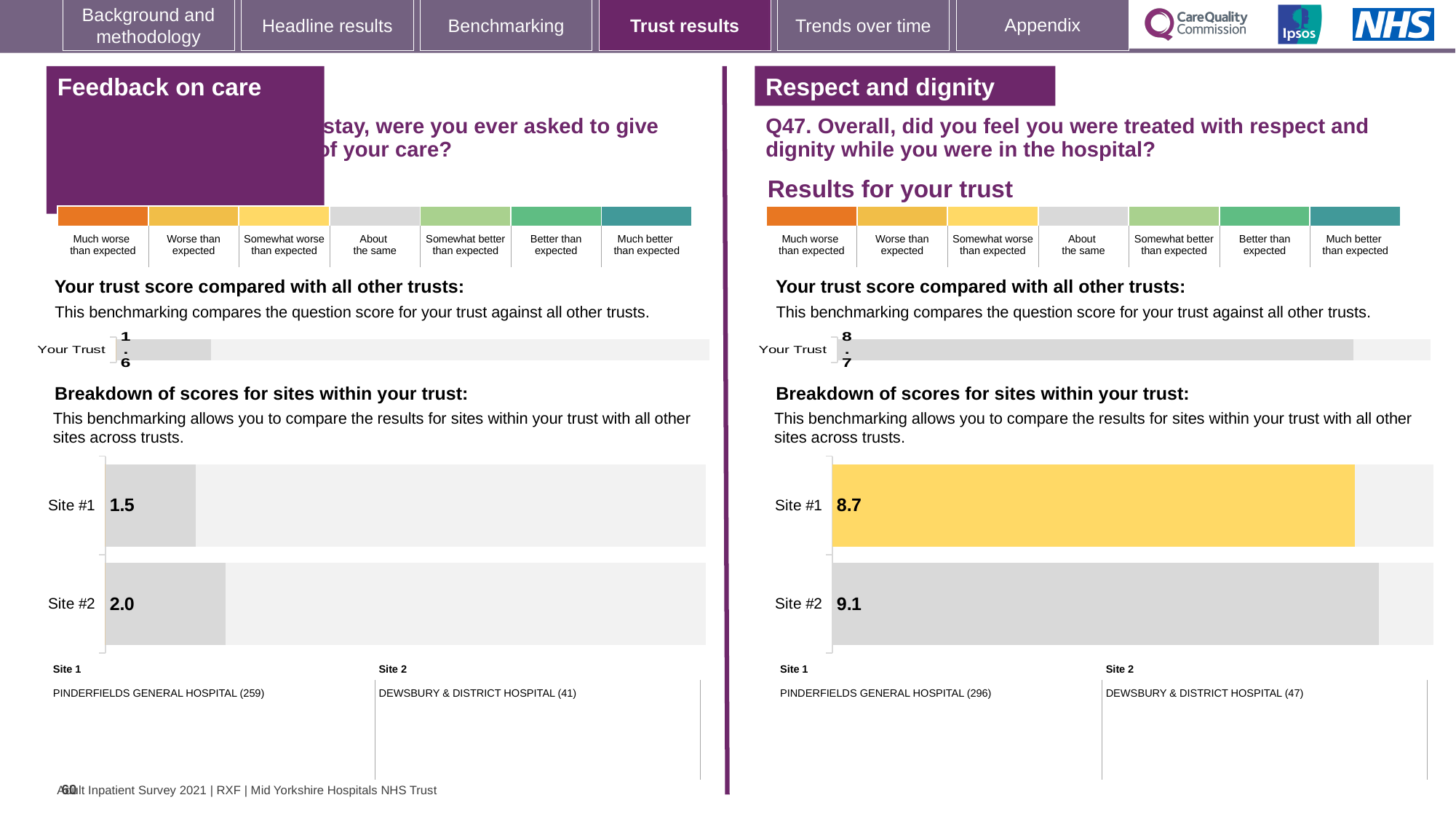
How many sites are shown on the 'Respect and dignity' site breakdown chart on the right? 2 On the 'Your Trust' chart in the 'Respect and dignity' section on the right, what is the trust score? 8.7 On the 'Respect and dignity' site breakdown chart on the right, what is the score for Site #2? 9.1 On the 'Feedback on care' site breakdown chart on the left, what is the score for Site #1? 1.5 On the 'Your Trust' chart in the 'Feedback on care' section on the left, what is the trust score? 1.6 On the 'Respect and dignity' site breakdown chart on the right, what is the score for Site #1? 8.7 On the 'Feedback on care' site breakdown chart on the left, what is the score for Site #2? 2.0 On the 'Respect and dignity' site breakdown chart on the right, what is the difference between the Site #2 and Site #1 scores? 0.4 What type of chart is the site breakdown chart in the 'Feedback on care' section on the left? Bar chart On the 'Feedback on care' site breakdown chart on the left, which site has the lower score? Site #1 On the 'Feedback on care' site breakdown chart on the left, what is the difference between the Site #2 and Site #1 scores? 0.5 On the 'Respect and dignity' site breakdown chart on the right, which site has the higher score? Site #2